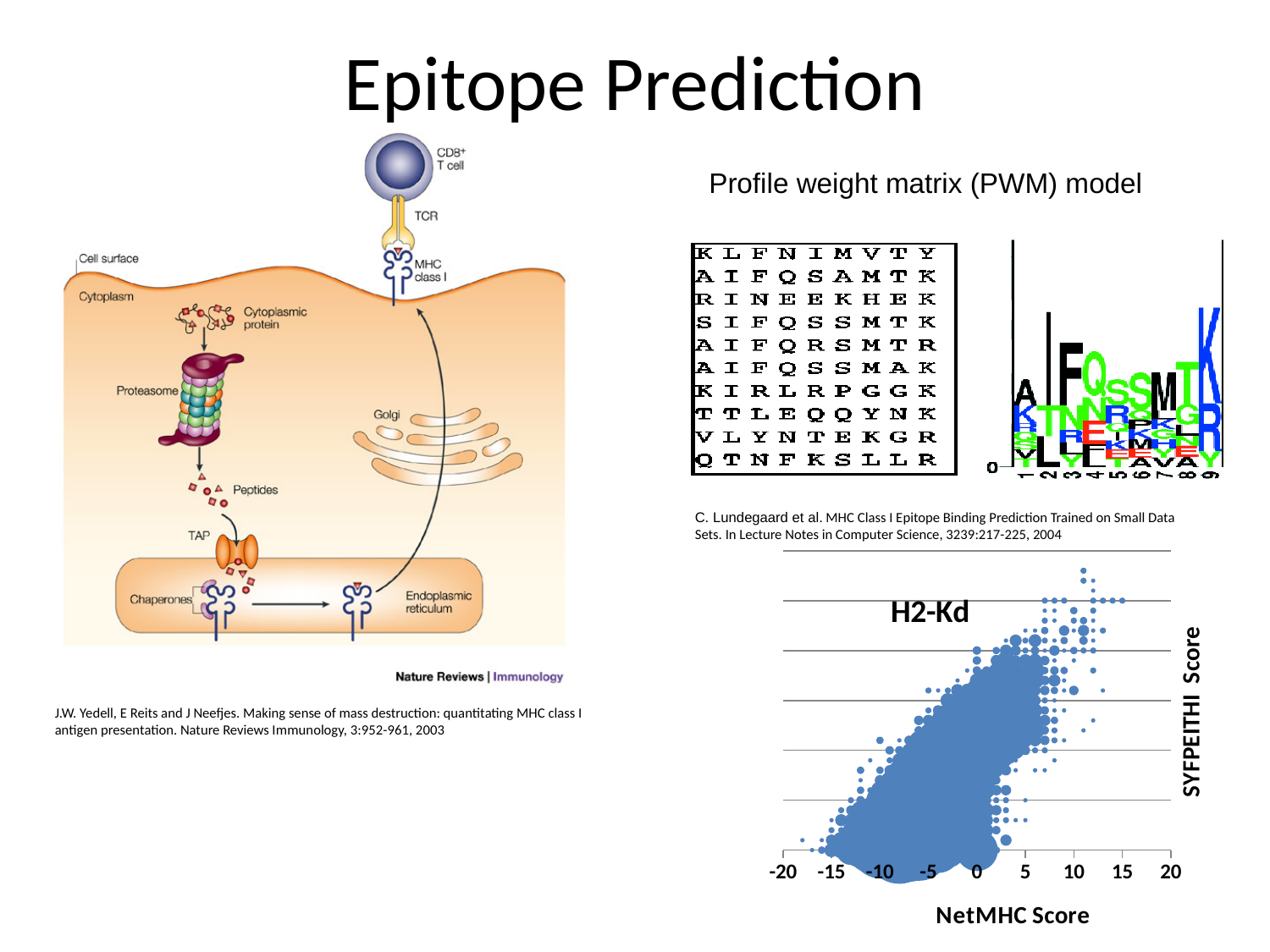
In the H2-Kd scatter plot, do the SYFPEITHI Score values generally rise or fall as the NetMHC Score increases? rise In the sequence logo chart at the top right, which letter is tallest at position 4? Q What is the x-axis title of the H2-Kd scatter plot? NetMHC Score What kind of chart is the H2-Kd chart at the bottom right of the slide? bubble chart How many positions are shown on the x axis of the sequence logo chart at the top right? 9 What is the y-axis title of the H2-Kd scatter plot? SYFPEITHI Score How many tick labels are shown on the x axis of the H2-Kd scatter plot? 9 In the sequence logo chart at the top right, which letter is tallest at position 3? F